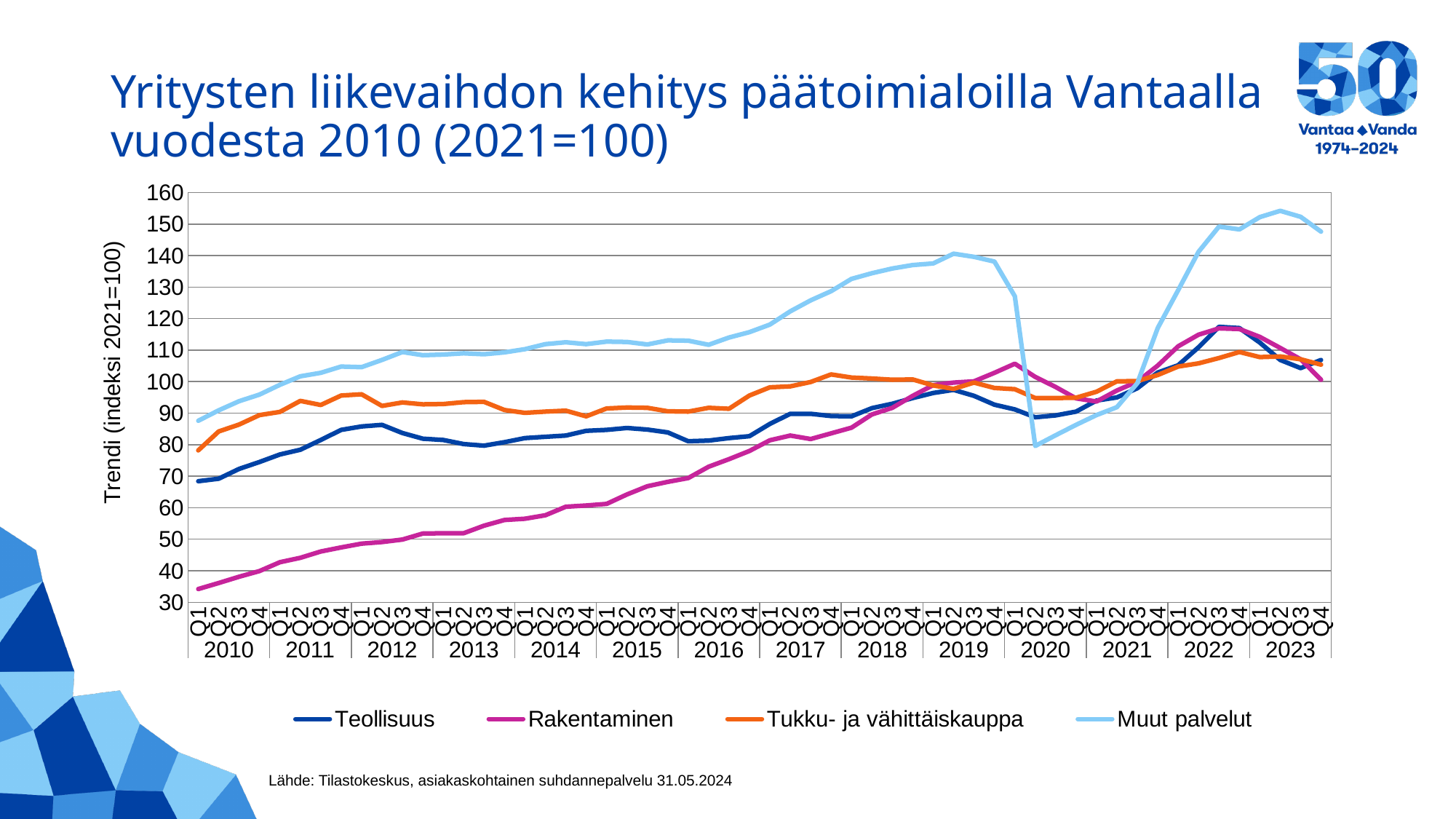
What kind of chart is shown on the slide? line chart Is the value for Muut palvelut in Q2 2022 greater or less than 150? less Does the Rakentaminen series generally rise or fall from 2010 to 2019? rise Is the value for Teollisuus in Q1 2010 greater or less than 70? less How many series does the legend list? 4 Which series has the highest value in Q2 2022? Muut palvelut Is the value for Rakentaminen in Q1 2010 greater or less than 40? less Which series has the lowest value in Q1 2010? Rakentaminen What is the title of the vertical axis? Trendi (indeksi 2021=100) Which series are listed in the legend? Teollisuus, Rakentaminen, Tukku- ja vähittäiskauppa, Muut palvelut In Q2 2020, which is larger: the value for Teollisuus or the value for Muut palvelut? Teollisuus